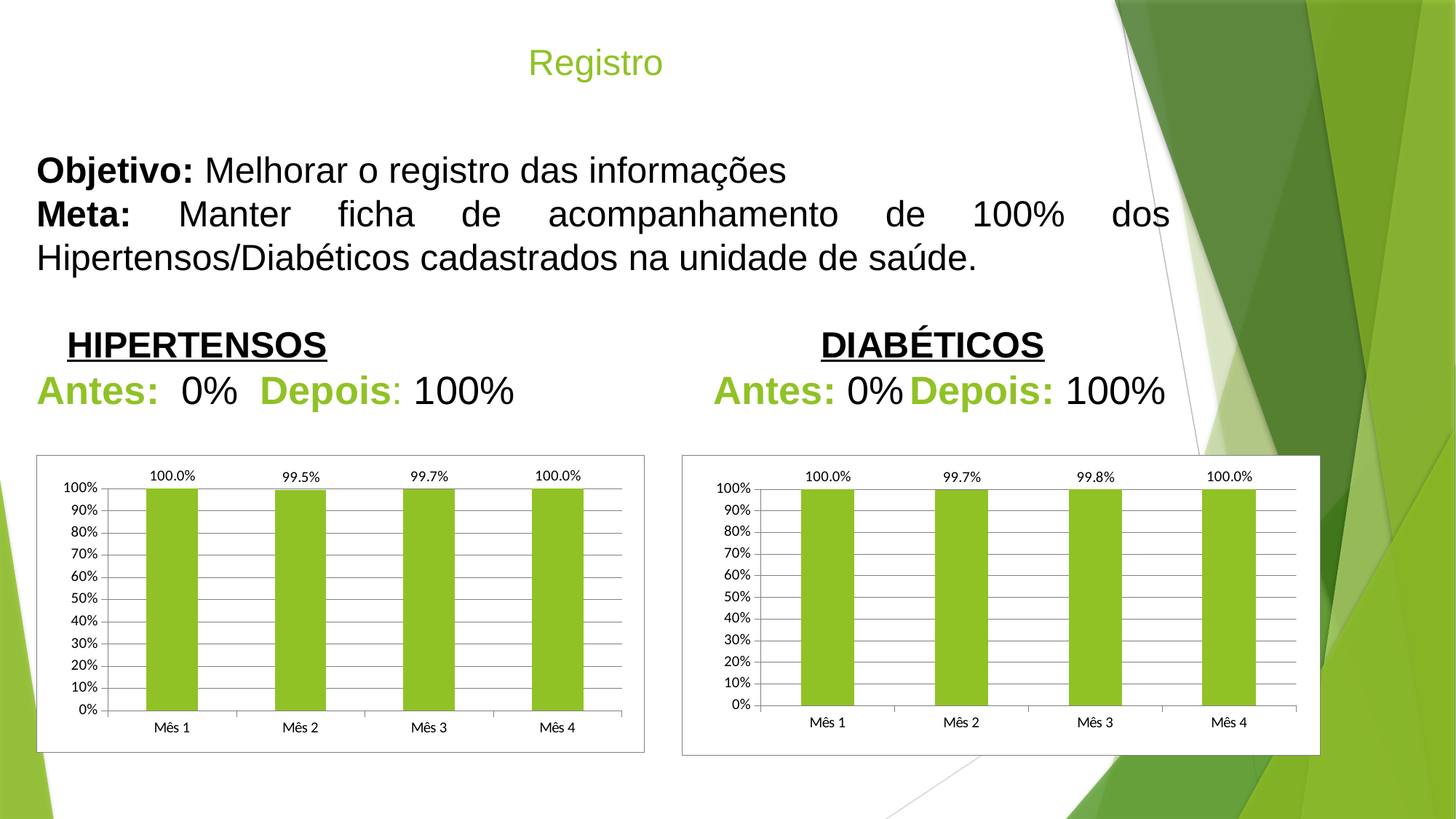
In the DIABÉTICOS chart on the right, what is the value for Mês 1? 100.0% How many months are shown on the x axis of the HIPERTENSOS chart on the left? 4 In the HIPERTENSOS chart on the left, which month has the lowest value? Mês 2 In the DIABÉTICOS chart on the right, what is the value for Mês 3? 99.8% In the HIPERTENSOS chart on the left, what is the value for Mês 3? 99.7% In the DIABÉTICOS chart on the right, what is the difference between the values for Mês 4 and Mês 2? 0.3% What kind of chart is the DIABÉTICOS chart on the right? Bar chart What colour are the bars in the HIPERTENSOS chart on the left? Green In the HIPERTENSOS chart on the left, what is the value for Mês 2? 99.5% In the DIABÉTICOS chart on the right, what is the value for Mês 2? 99.7% In the HIPERTENSOS chart on the left, what is the difference between the values for Mês 1 and Mês 2? 0.5% In the DIABÉTICOS chart on the right, which month has the lowest value? Mês 2